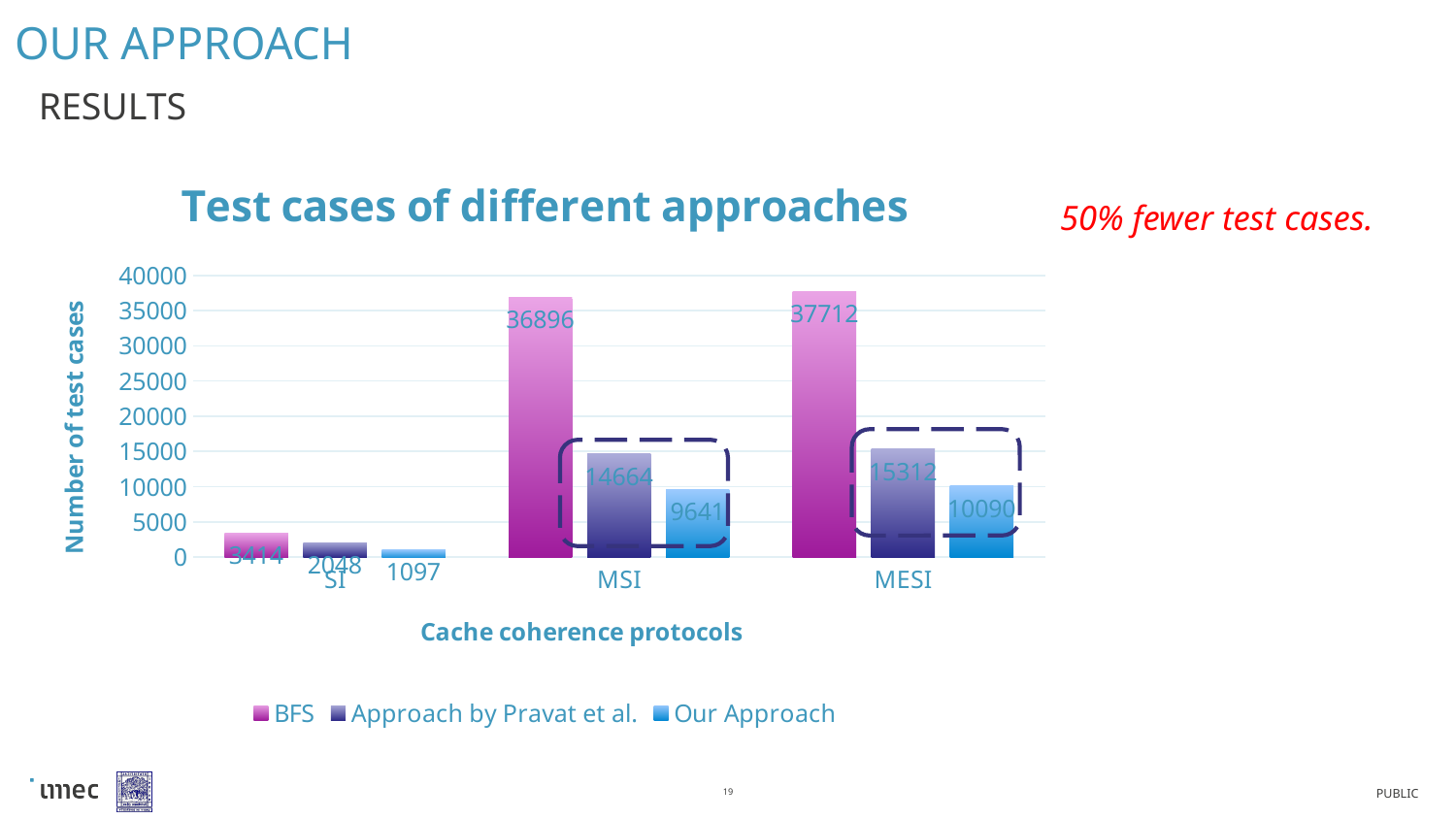
What type of chart is shown on the slide? bar chart Which protocol has the lowest number of test cases for Our Approach? SI For the MESI protocol, which has more test cases: the Approach by Pravat et al. or Our Approach? Approach by Pravat et al. How many cache coherence protocols are shown on the x axis? 3 What is the title of the chart? Test cases of different approaches How many series does the legend list? 3 What is the number of test cases for the Approach by Pravat et al. on the SI protocol? 2048 What is the number of test cases for BFS on the MSI protocol? 36896 What is the difference between the BFS and Our Approach test cases for the MSI protocol? 27255 What is the label of the y axis? Number of test cases Which protocol has the highest number of test cases for BFS? MESI What is the number of test cases for Our Approach on the MESI protocol? 10090